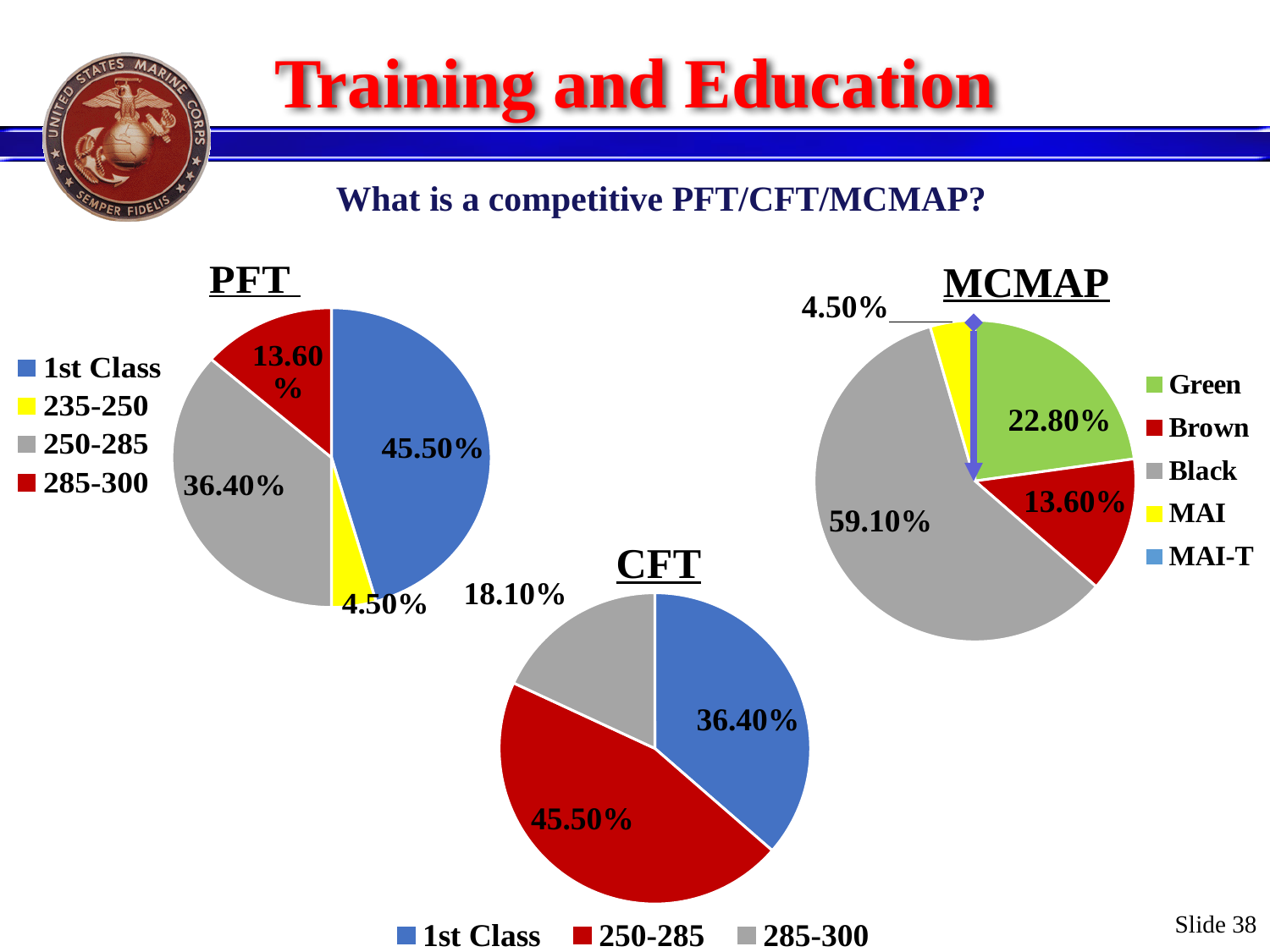
On the MCMAP chart, what percentage is shown for Green? 22.80% On the PFT chart, what percentage is shown for the 250-285 slice? 36.40% On the CFT chart, which category has the largest slice? 250-285 On the PFT chart, which category has the smallest slice? 235-250 On the PFT chart, how many categories does the legend list? 4 On the MCMAP chart, which is larger, Green or Brown? Green On the PFT chart, what share of the pie is 1st Class? 45.50% On the CFT chart, what percentage is shown for 250-285? 45.50% On the CFT chart, what is the difference between the 1st Class and 285-300 slices? 18.30% On the MCMAP chart, how many entries does the legend list? 5 On the MCMAP chart, what percentage is shown for Black? 59.10% What type of chart is the CFT chart? Pie chart